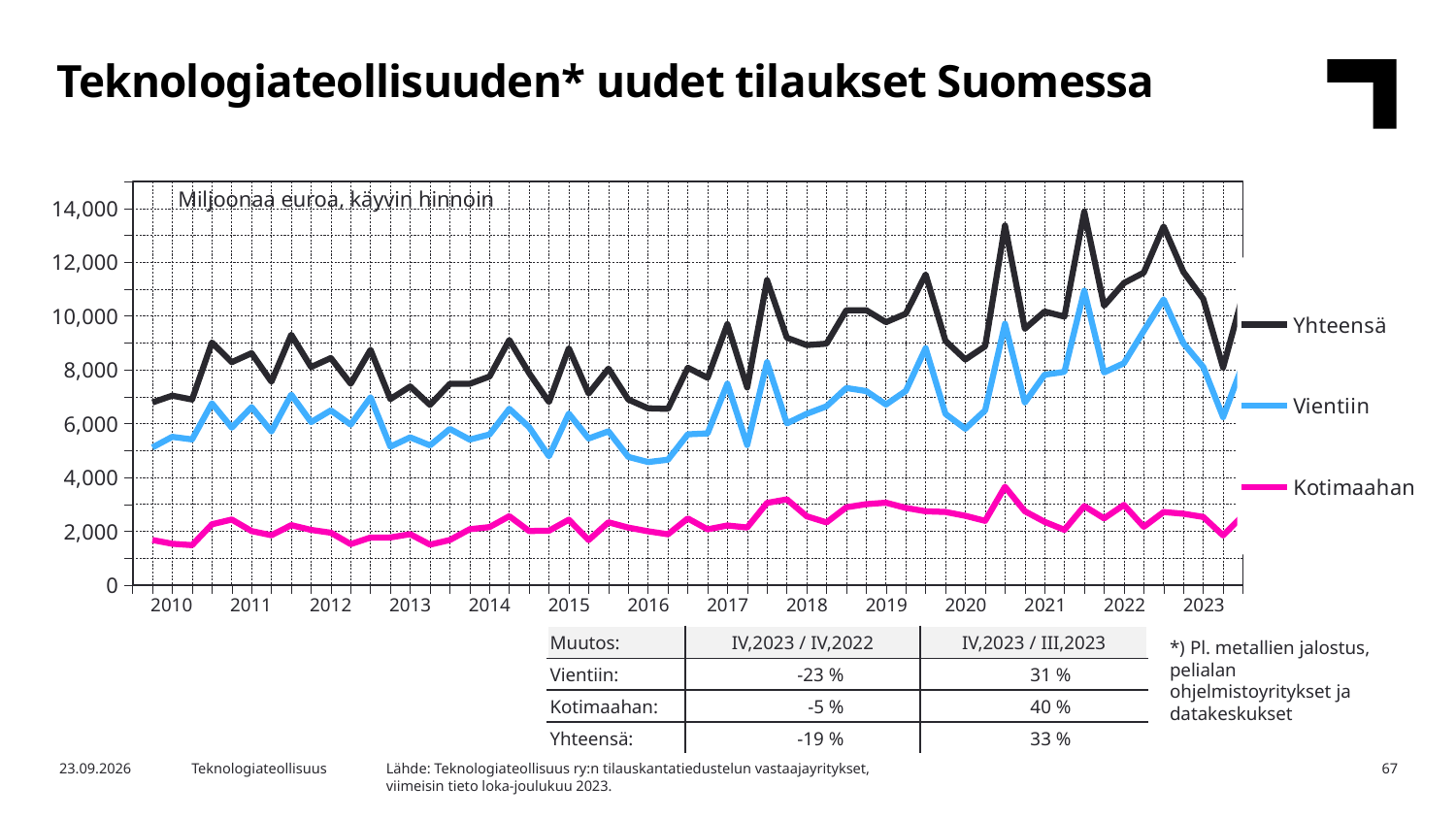
Which series has the lowest values throughout the chart? Kotimaahan Which series has the highest values throughout the chart? Yhteensä Which is larger in 2021, Vientiin or Kotimaahan? Vientiin What kind of chart is shown on the slide? line chart Is the lowest value for Vientiin around 2016 greater or less than 6,000? less What are the three series named in the legend? Yhteensä, Vientiin, Kotimaahan How many year labels are shown on the x axis? 14 How many series does the legend list? 3 Is the value for Yhteensä at the start of 2010 greater or less than 8,000? less Overall, do the Yhteensä values rise or fall from 2010 to 2023? rise Is the value for Kotimaahan ever greater or less than 4,000 over the whole period? less What unit is stated at the top of the chart area? Miljoonaa euroa, käyvin hinnoin